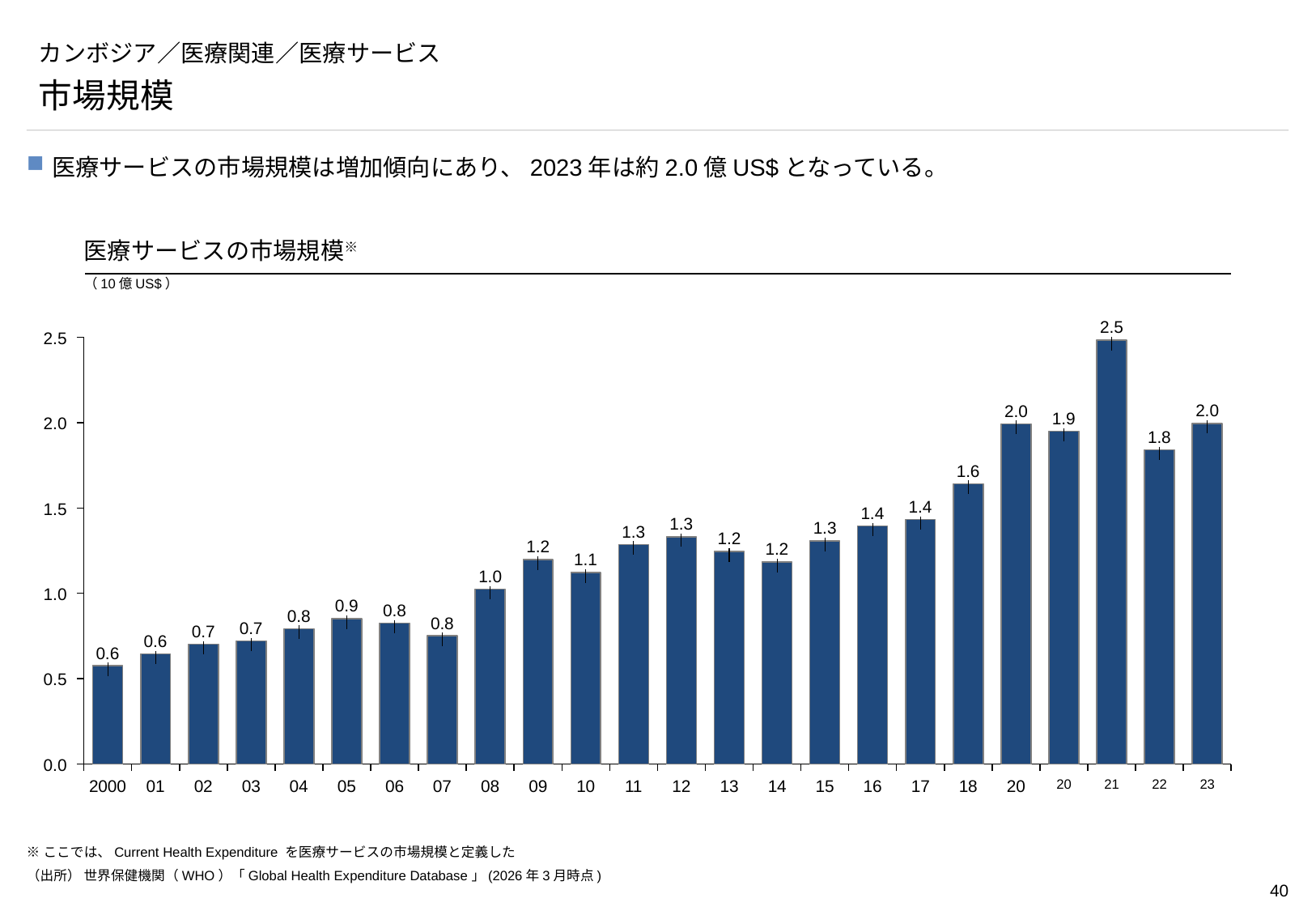
What is the value for 2000 in the chart? 0.6 Do the values generally rise or fall from 2000 to 23? rise Is the value for 17 greater or less than 1.5? less What kind of chart is shown on the slide? bar chart What unit is shown for the chart's values? 10億US$ What is the value for 05 in the chart? 0.9 What is the value for 09 in the chart? 1.2 How many bars are plotted in the chart? 24 Which is larger, the value for 18 or the value for 22? 22 Which year has the highest value in the chart? 21 What is the value for 23 in the chart? 2.0 What is the difference between the values for 21 and 23? 0.5